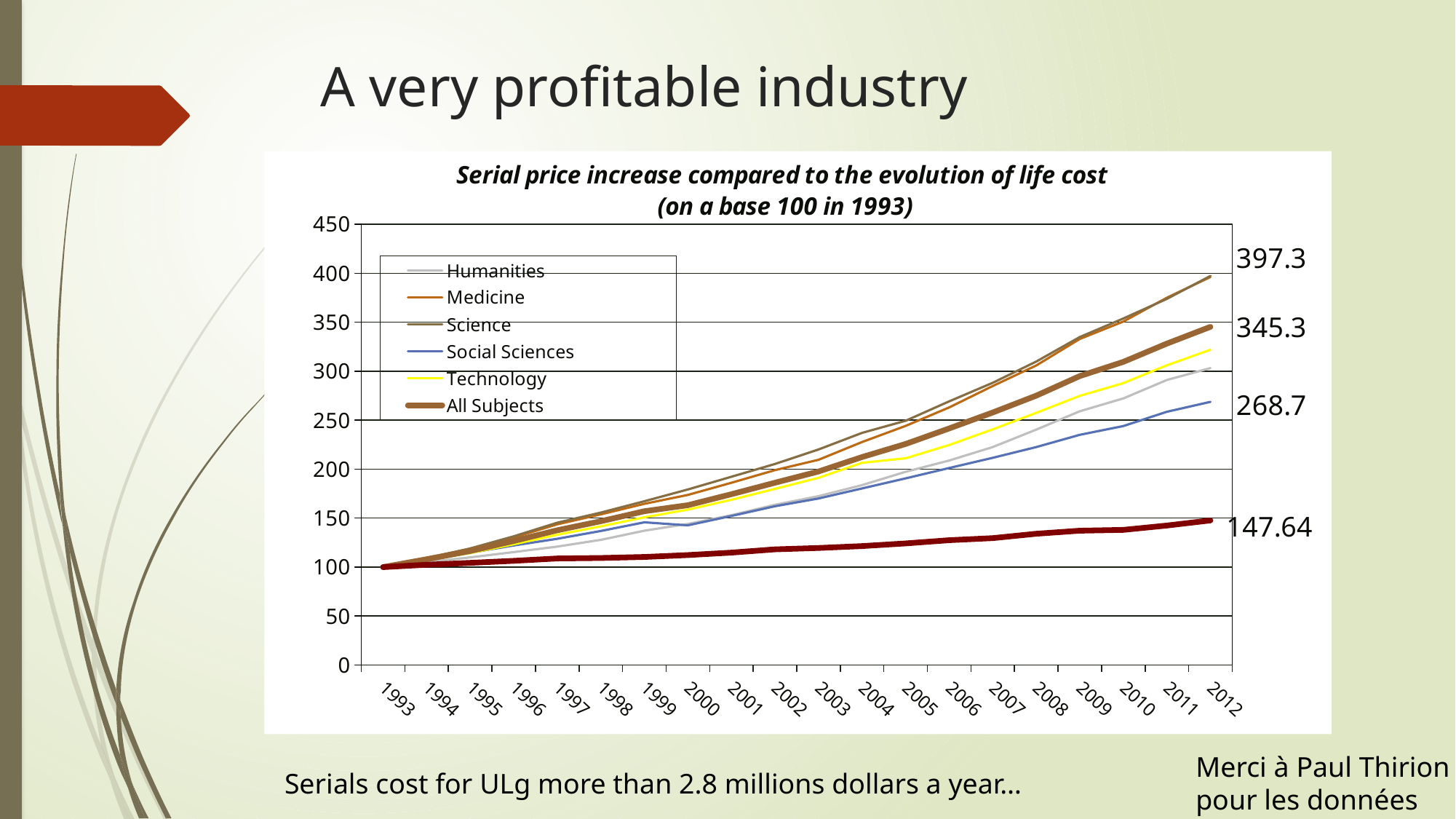
Is the value for Technology in 2012 greater or less than 300? greater What is the title of the chart? Serial price increase compared to the evolution of life cost (on a base 100 in 1993) What kind of chart is shown on the slide? line chart What is the value labelled for All Subjects in 2012? 345.3 Do the series values generally rise or fall from 1993 to 2012? rise Is the value for All Subjects in 2005 greater or less than 250? less How many series does the chart legend list? 6 In 2012, which is higher: Technology or Humanities? Technology What is the difference between the 2012 values labelled for All Subjects and Social Sciences? 76.6 What is the value labelled for Social Sciences in 2012? 268.7 Among the series listed in the legend, which has the lowest value in 2012? Social Sciences How many years are shown along the x axis of the chart? 20